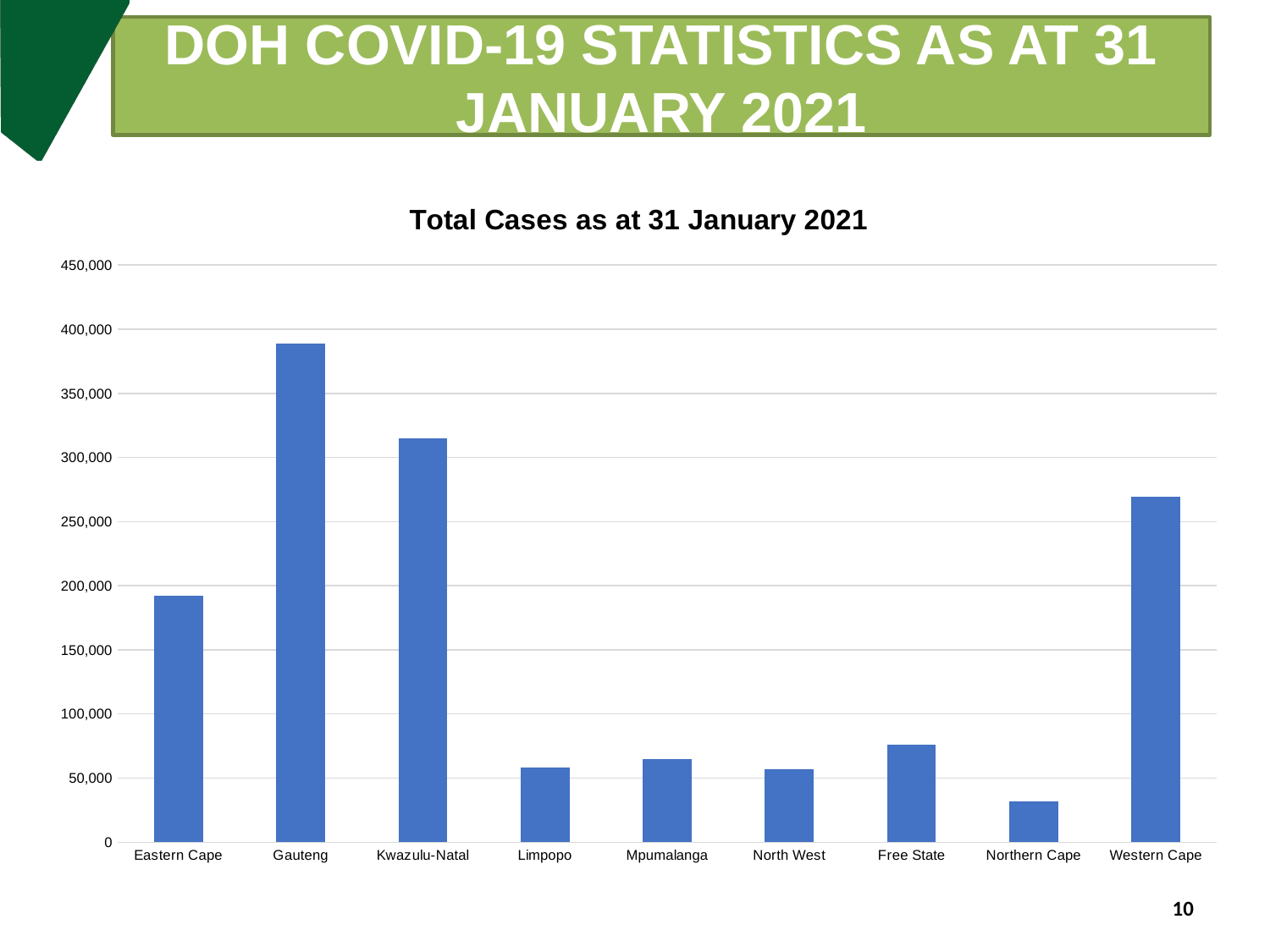
Which province has the highest number of total cases? Gauteng Is the value for Northern Cape greater or less than 50,000? less Which has more total cases, Western Cape or Eastern Cape? Western Cape Is the value for Gauteng greater or less than 350,000? greater Is the value for Eastern Cape greater or less than 200,000? less Which has more total cases, Gauteng or Kwazulu-Natal? Gauteng Which province has the lowest number of total cases? Northern Cape Which has more total cases, Free State or Northern Cape? Free State What type of chart is shown on the slide? Bar chart How many provinces are shown on the x axis of the chart? 9 What is the title of the chart? Total Cases as at 31 January 2021